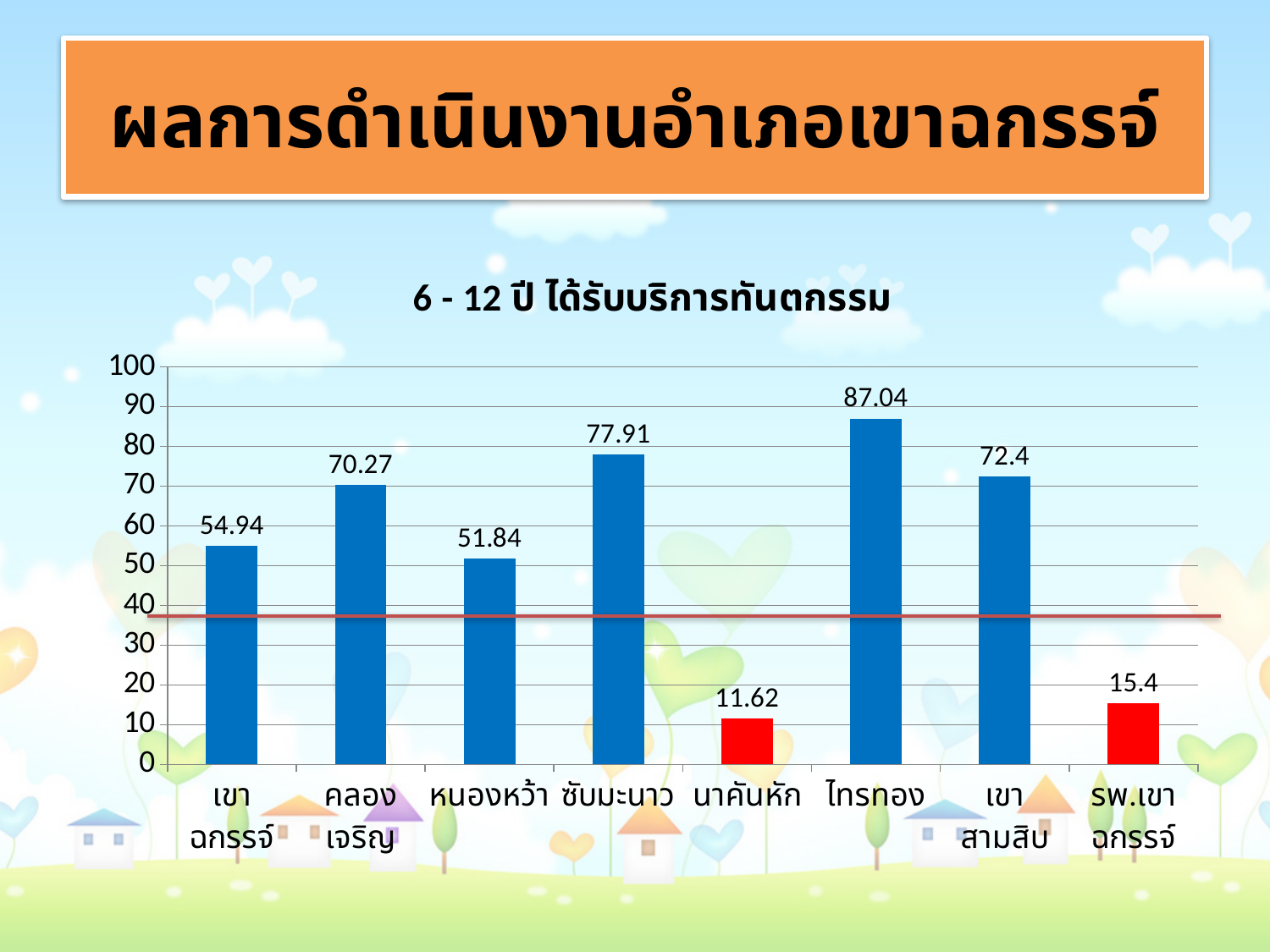
What kind of chart is shown on the slide? bar chart Which two categories have red bars instead of blue? นาคันหัก and รพ.เขาฉกรรจ์ How many categories are shown on the x axis? 8 What is the title of the chart? 6 - 12 ปี ได้รับบริการทันตกรรม Which category has the lowest value? นาคันหัก What is the value for ไทรทอง? 87.04 What is the value for เขาสามสิบ? 72.4 Which category has the highest value? ไทรทอง What is the value for นาคันหัก? 11.62 Which is larger, the value for คลองเจริญ or the value for เขาฉกรรจ์? คลองเจริญ What is the difference between the values for ซับมะนาว and หนองหว้า? 26.07 Is the value for รพ.เขาฉกรรจ์ greater or less than 20? less